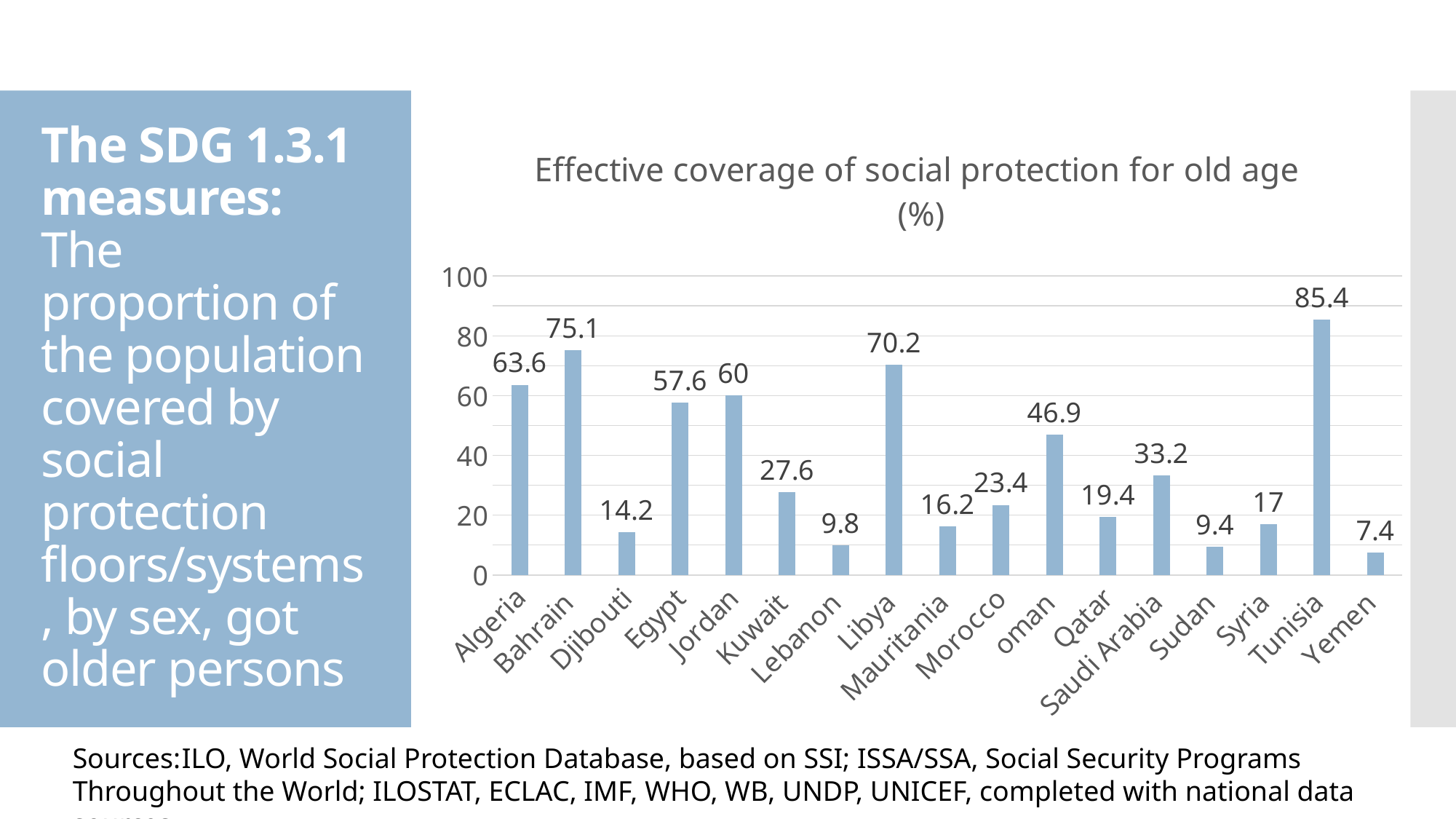
What kind of chart is shown on the slide? Bar chart What is the difference between the values for Tunisia and Yemen? 78 Which country has the lowest effective coverage of social protection for old age? Yemen What is the value shown for Saudi Arabia? 33.2 Which country has the highest effective coverage of social protection for old age? Tunisia How many countries are shown in the chart? 17 Is the value for Morocco greater or less than 40? less Which has a higher value, Libya or Egypt? Libya What is the difference between the values for Bahrain and Algeria? 11.5 What is the title of the chart? Effective coverage of social protection for old age (%) What is the value shown for Kuwait? 27.6 What is the effective coverage of social protection for old age in Tunisia? 85.4